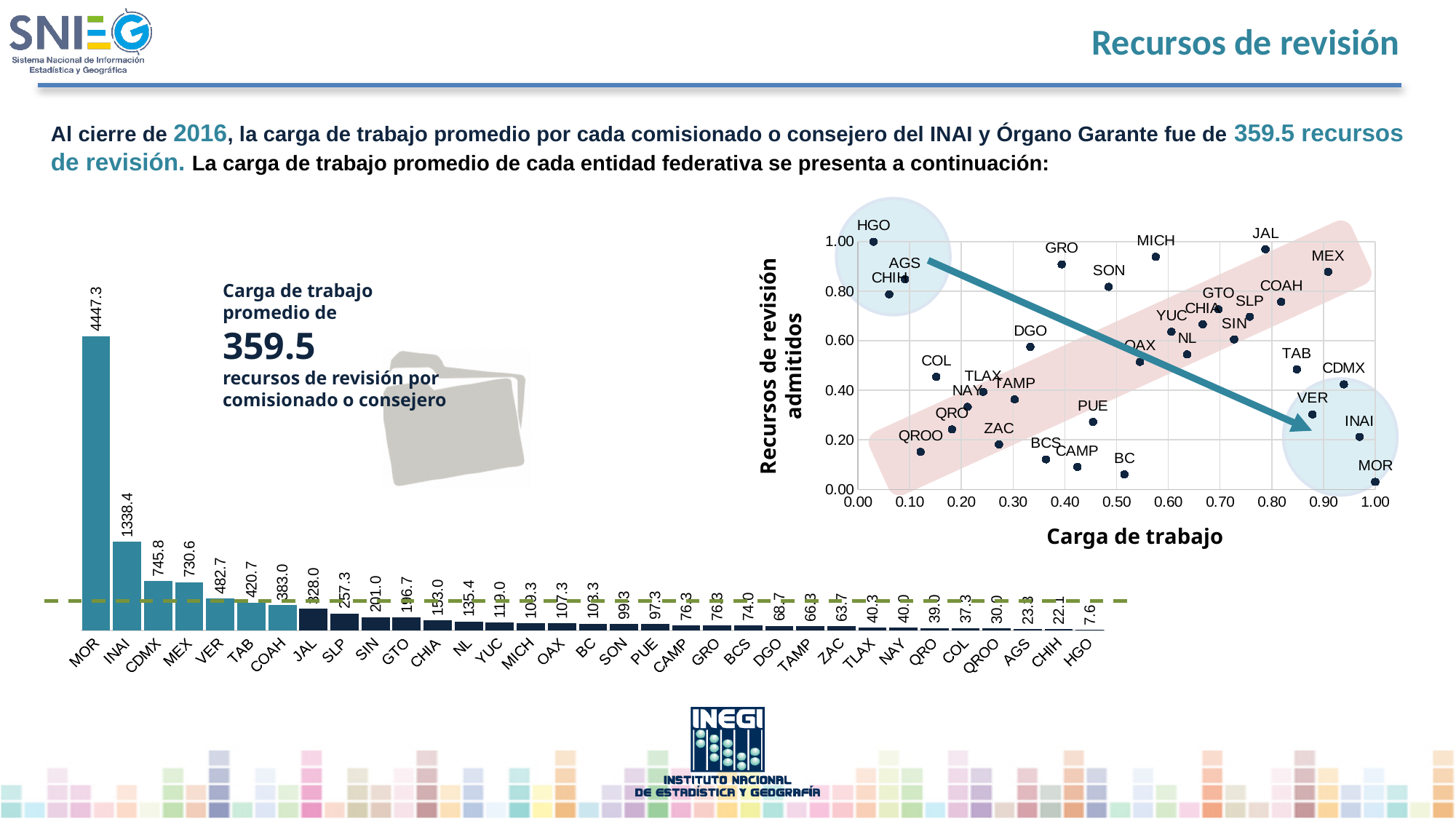
In the bar chart, what is the value for MOR? 4447.3 In the scatter plot, is the 'Carga de trabajo' value for MOR greater or less than 0.90? greater In the bar chart, which category has the lowest value? HGO In the bar chart, what is the difference between the values for CDMX and MEX? 15.2 What kind of chart is the chart on the bottom left of the slide? Bar chart What kind of chart is the chart on the right of the slide? Scatter plot In the bar chart, what is the value for HGO? 7.6 How many categories does the bar chart show? 33 In the bar chart, which category has the highest value? MOR In the scatter plot, what is the label of the x axis? Carga de trabajo In the bar chart, what is the value for INAI? 1338.4 In the bar chart, which is larger, the value for VER or the value for TAB? VER